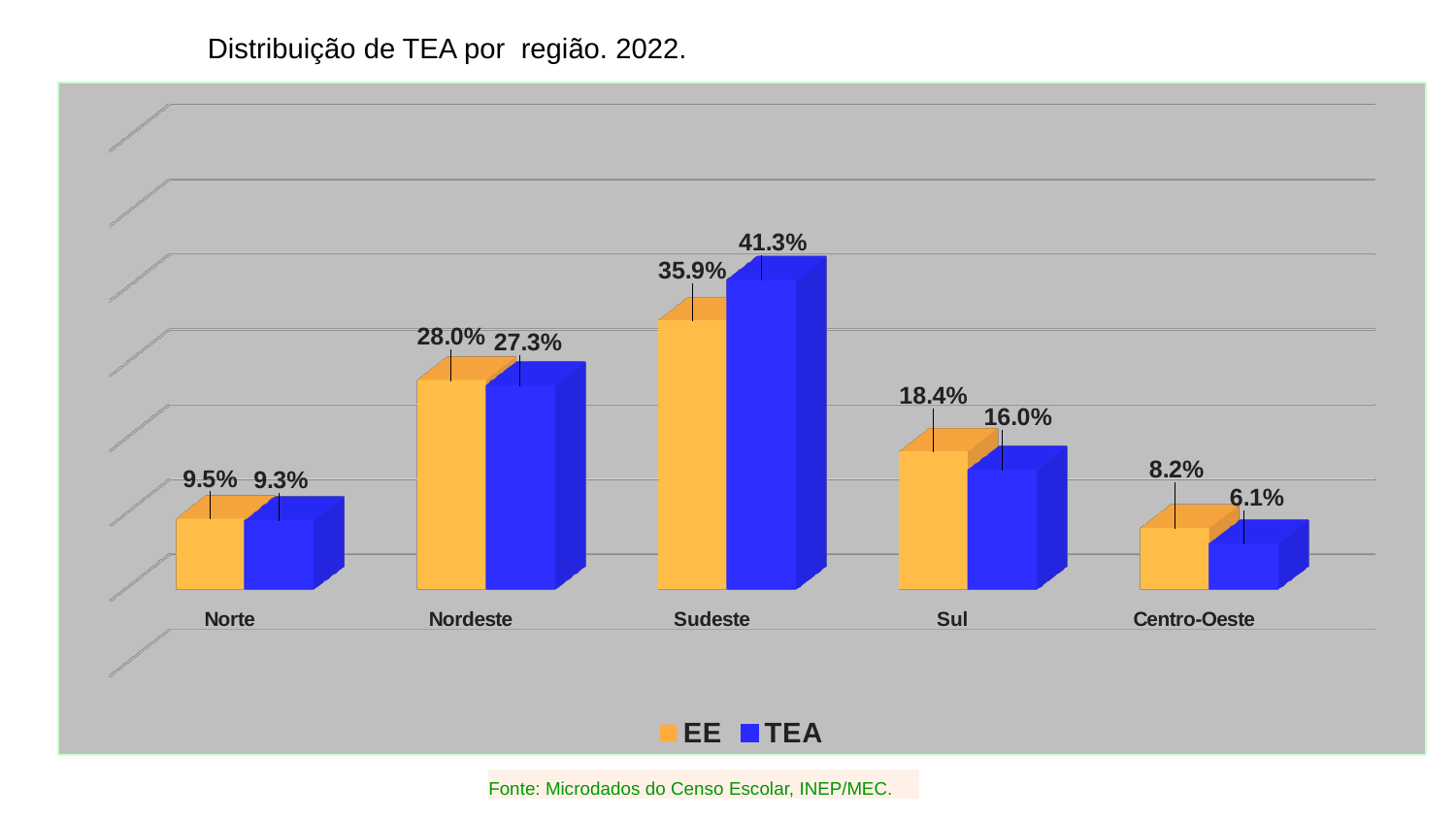
What is the EE value for Sul? 18.4% How many regions are shown on the x axis? 5 Which is larger for Sul, the EE value or the TEA value? EE What is the difference between the EE values for Nordeste and Sul? 9.6% Which region has the highest TEA value? Sudeste What is the difference between the TEA and EE values for Sudeste? 5.4% What is the TEA value for Nordeste? 27.3% What kind of chart is shown on the slide? Bar chart Which region has the lowest EE value? Centro-Oeste How many series does the legend list? 2 What is the TEA value for Centro-Oeste? 6.1% What is the EE value for Sudeste? 35.9%